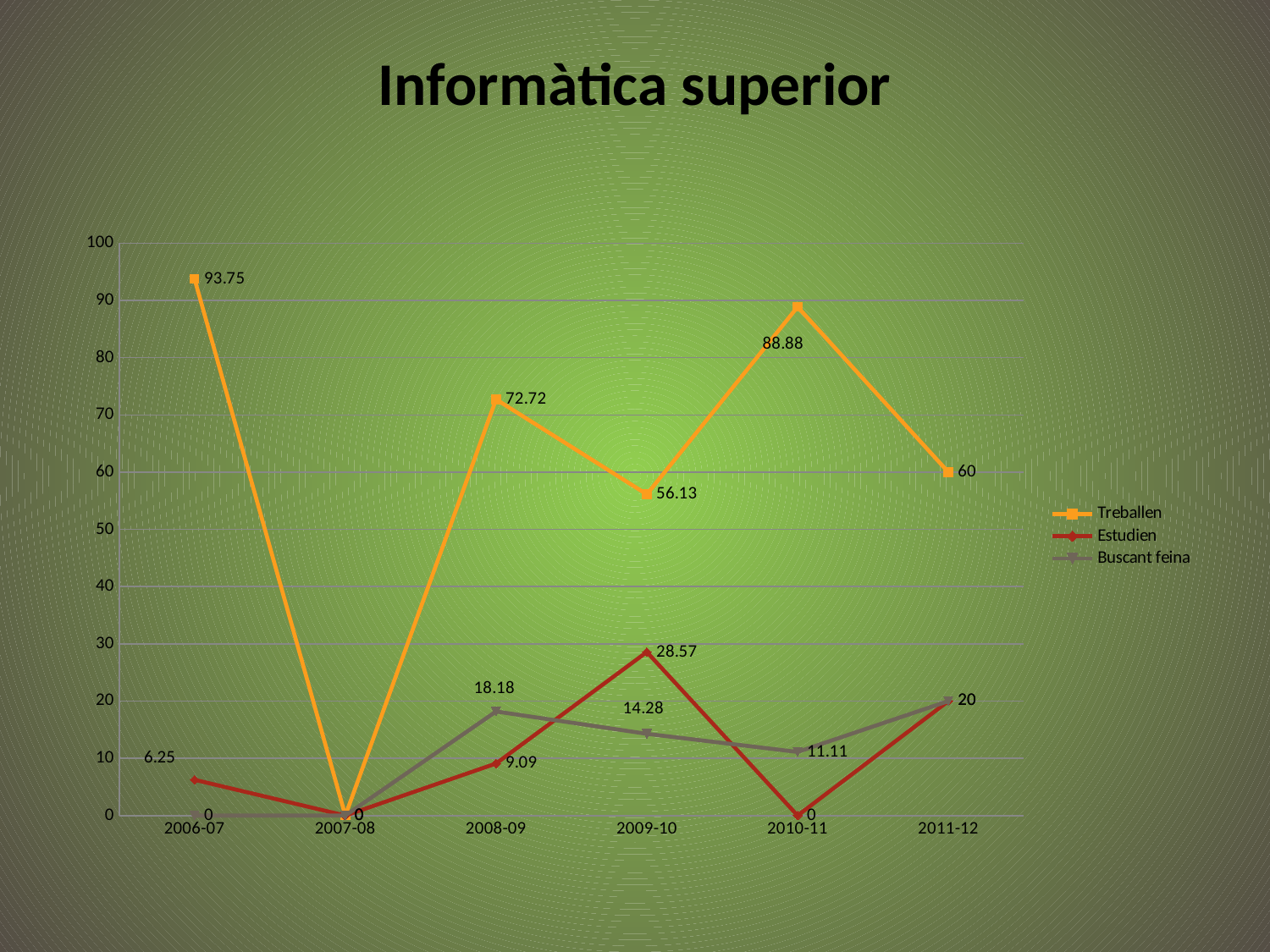
In 2009-10, which is larger: Estudien or Buscant feina? Estudien What is the difference between the Treballen values for 2010-11 and 2009-10? 32.75 How many years are shown on the x axis? 6 What is the value for Buscant feina in 2010-11? 11.11 What kind of chart is shown on the slide? Line chart What is the value for Buscant feina in 2008-09? 18.18 Does the Treballen value rise or fall from 2009-10 to 2010-11? Rise In which year is the Treballen value highest? 2006-07 How many series does the legend list? 3 What is the value for Estudien in 2009-10? 28.57 What is the value for Treballen in 2006-07? 93.75 In which year is the Treballen value lowest? 2007-08